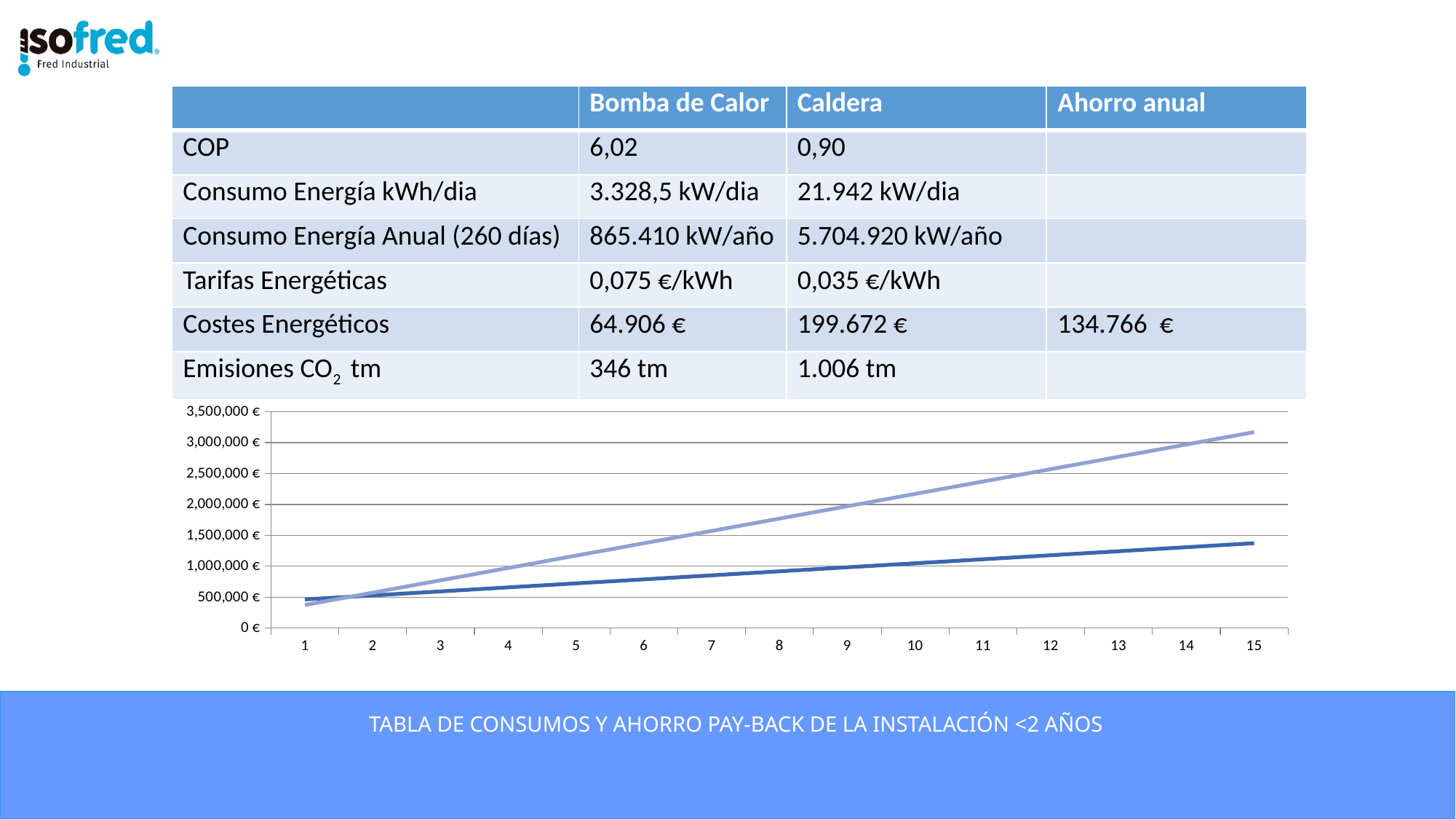
Is the value of the darker blue line at x = 15 greater or less than 1,500,000 €? less How many points are labelled along the x axis of the chart? 15 At x = 15, which line is higher in the chart, the lighter blue line or the darker blue line? the lighter blue line Does the lighter blue line in the chart rise or fall from x = 1 to x = 15? rise What kind of chart is shown below the table on the slide? line chart What is the lowest value labelled on the y axis of the chart? 0 € Does the darker blue line in the chart rise or fall from x = 1 to x = 15? rise Is the value of the lighter blue line at x = 15 greater or less than 3,000,000 €? greater Is the value of the lighter blue line at x = 8 greater or less than 1,500,000 €? greater What is the highest value labelled on the y axis of the chart? 3,500,000 € How many lines are plotted in the chart below the table? 2